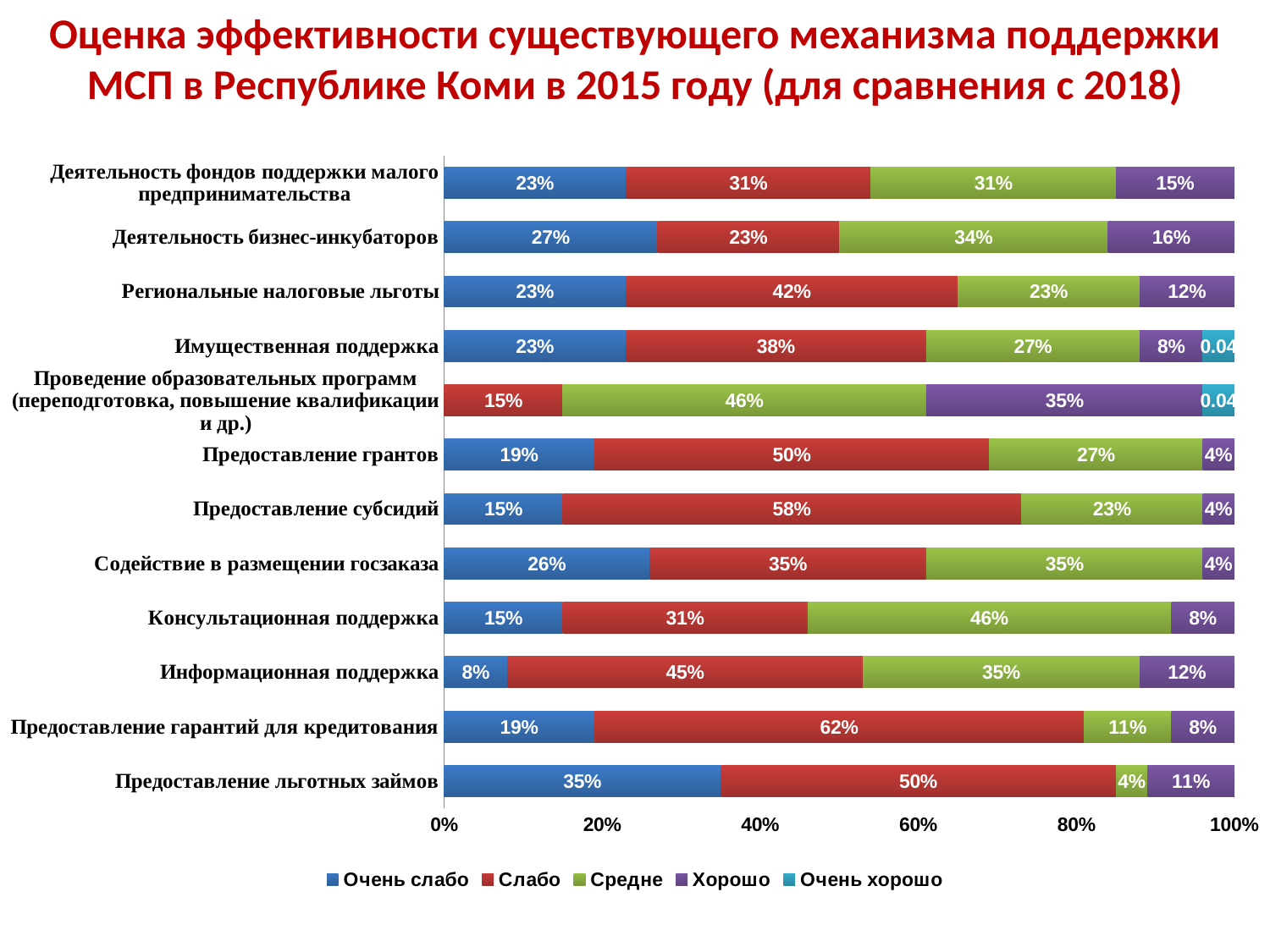
What is the 'Очень слабо' share for 'Предоставление льготных займов'? 35% What kind of chart is shown on the slide? Stacked bar chart How many support mechanisms (categories) are plotted on the chart? 12 Which has the larger 'Очень слабо' share: 'Деятельность бизнес-инкубаторов' or 'Деятельность фондов поддержки малого предпринимательства'? Деятельность бизнес-инкубаторов What is the 'Слабо' share for 'Предоставление гарантий для кредитования'? 62% Which category has the highest 'Хорошо' share? Проведение образовательных программ (переподготовка, повышение квалификации и др.) What colour represents the 'Слабо' series in the legend? Red For 'Региональные налоговые льготы', what is the difference between the 'Слабо' share and the 'Средне' share? 19 percentage points What is the 'Хорошо' share for 'Деятельность бизнес-инкубаторов'? 16% Which category has the highest 'Слабо' share? Предоставление гарантий для кредитования How many series does the legend list? 5 What is the 'Средне' share for 'Консультационная поддержка'? 46%